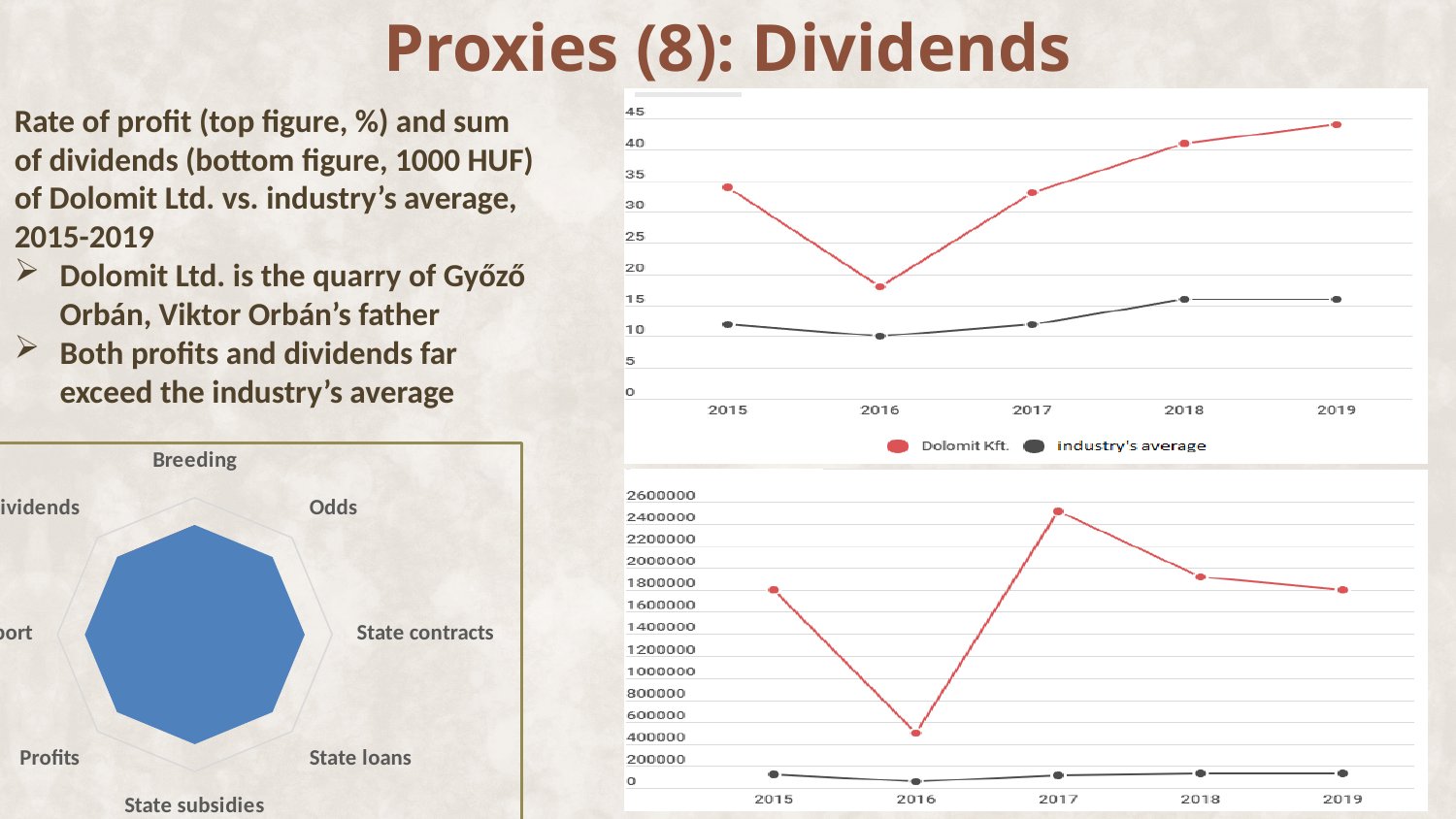
How many series does the legend of the top chart on the right list? 2 How many years are plotted along the x axis of the top chart on the right? 5 In the top chart on the right, is the Dolomit Kft. value for 2016 greater or less than 20? less In the top chart on the right, does the Dolomit Kft. line rise or fall from 2016 to 2019? rise In the bottom chart on the right, in which year is the Dolomit Kft. value highest? 2017 In the top chart on the right, in which year is the Dolomit Kft. value highest? 2019 In the top chart on the right, which series has the higher value in 2019, Dolomit Kft. or industry's average? Dolomit Kft. In the bottom chart on the right, is the Dolomit Kft. value for 2016 greater or less than 600000? less What kind of chart is the top chart on the right side of the slide? line chart In the top chart on the right, in which year is the Dolomit Kft. value lowest? 2016 What are the two series named in the legend of the top chart on the right? Dolomit Kft. and industry's average In the top chart on the right, is the Dolomit Kft. value for 2018 greater or less than 35? greater